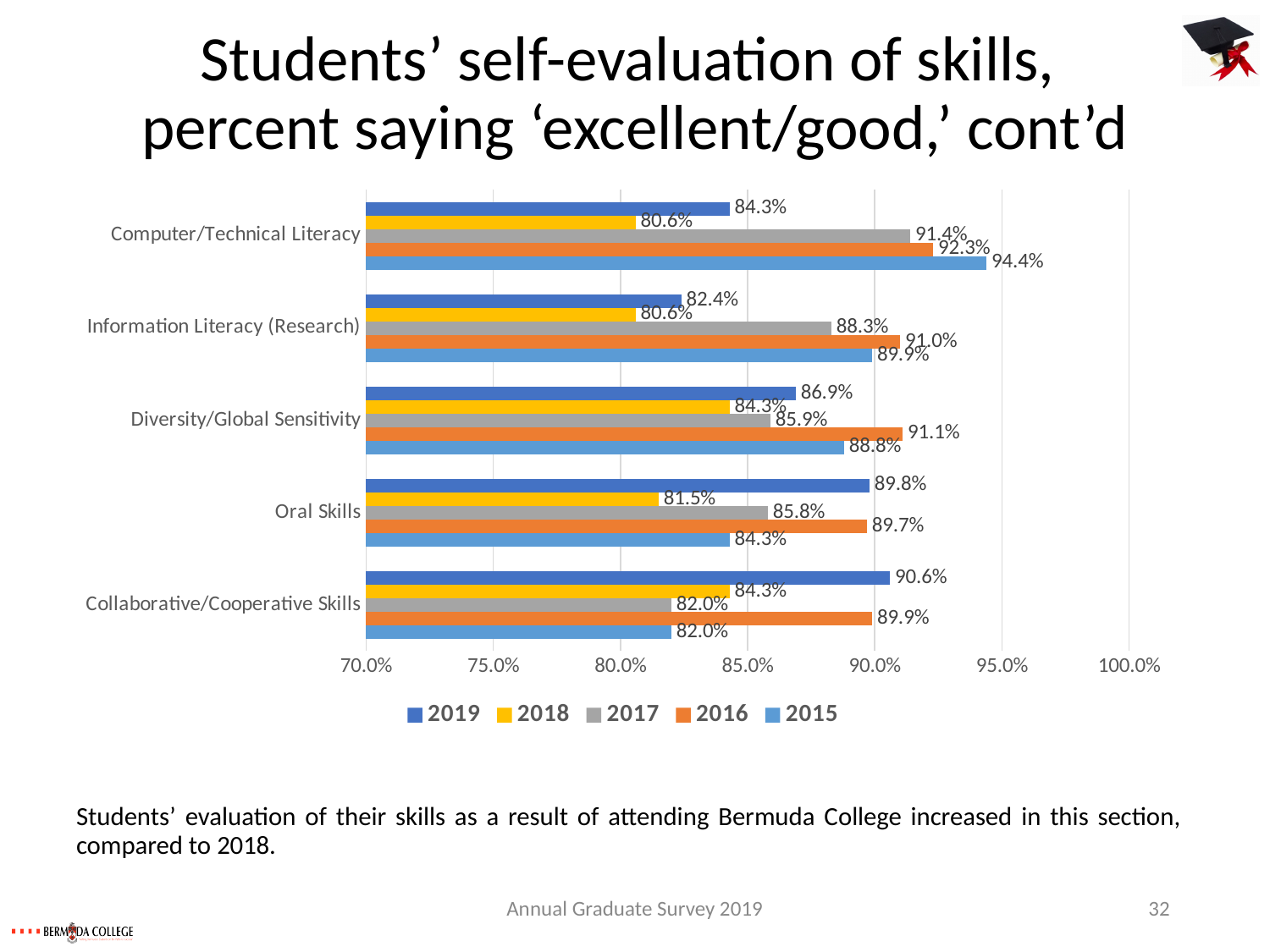
Is the 2017 value for Collaborative/Cooperative Skills greater or less than 85.0%? less Which category has the highest 2019 value? Collaborative/Cooperative Skills Which is larger for Diversity/Global Sensitivity, the 2016 value or the 2019 value? 2016 What is the 2018 value for Oral Skills? 81.5% Which year has the lowest value for Computer/Technical Literacy? 2018 What is the 2019 value for Computer/Technical Literacy? 84.3% How many series does the legend list? 5 What is the 2016 value for Information Literacy (Research)? 91.0% What kind of chart is shown on the slide? Bar chart What is the difference between the 2015 and 2019 values for Computer/Technical Literacy? 10.1% What is the 2015 value for Collaborative/Cooperative Skills? 82.0% How many skill categories are shown on the chart? 5